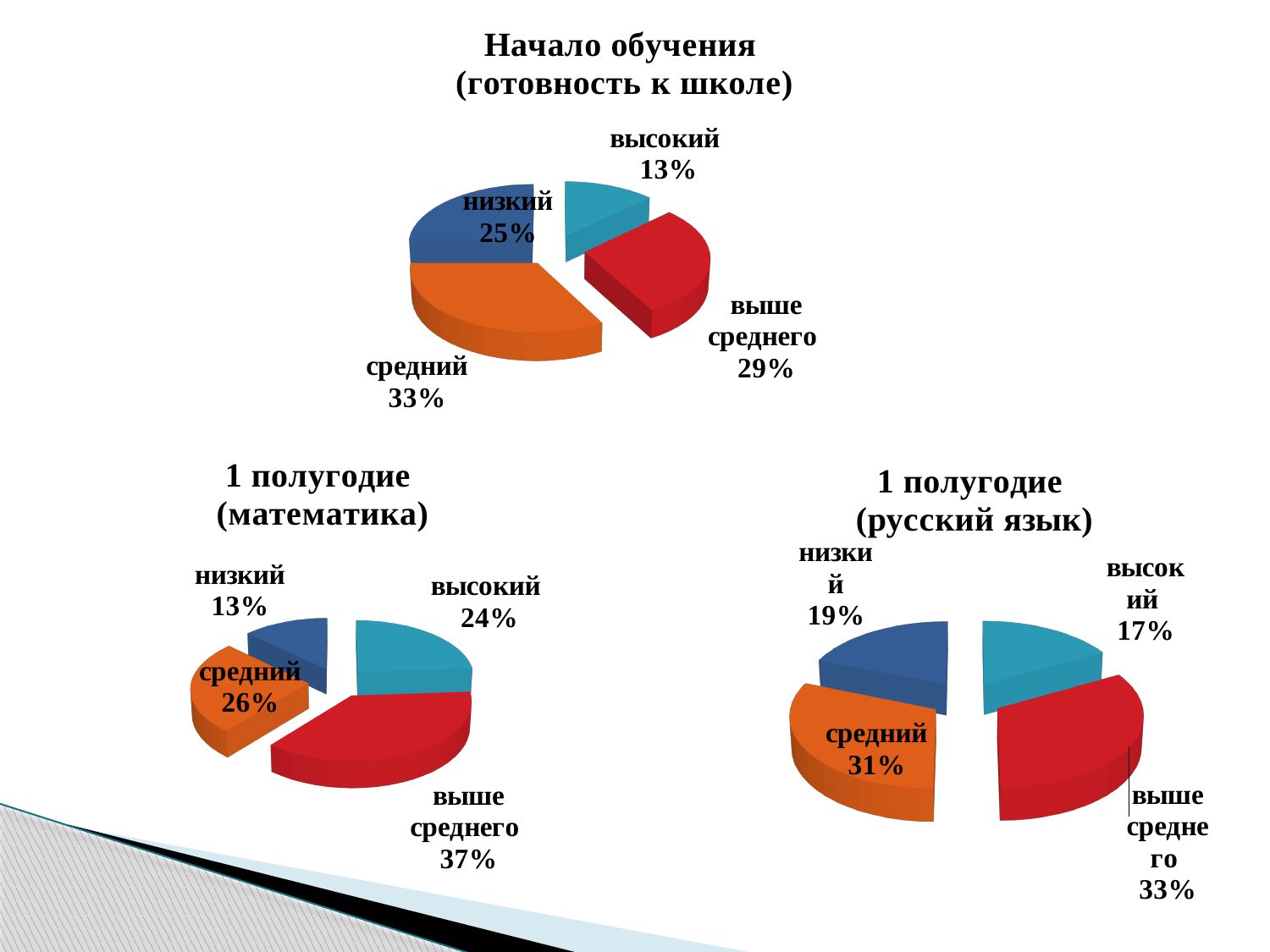
How many categories does the chart titled "1 полугодие (русский язык)" show? 4 In the chart titled "Начало обучения (готовность к школе)", which category has the smallest slice? высокий In the chart titled "Начало обучения (готовность к школе)", what share is labelled for "средний"? 33% In the chart titled "1 полугодие (русский язык)", what is the difference between the "средний" and "высокий" shares? 14% In the chart titled "Начало обучения (готовность к школе)", what is the difference between the "выше среднего" and "низкий" shares? 4% In the chart titled "1 полугодие (русский язык)", what share is labelled for "низкий"? 19% In the chart titled "1 полугодие (русский язык)", which category has the smallest slice? высокий What kind of chart is the chart titled "1 полугодие (математика)"? Pie chart In the chart titled "1 полугодие (математика)", which is larger, "высокий" or "средний"? средний In the chart titled "1 полугодие (математика)", what share is labelled for "выше среднего"? 37% In the chart titled "Начало обучения (готовность к школе)", what colour is the "средний" slice? Orange In the chart titled "1 полугодие (математика)", which category has the largest slice? выше среднего